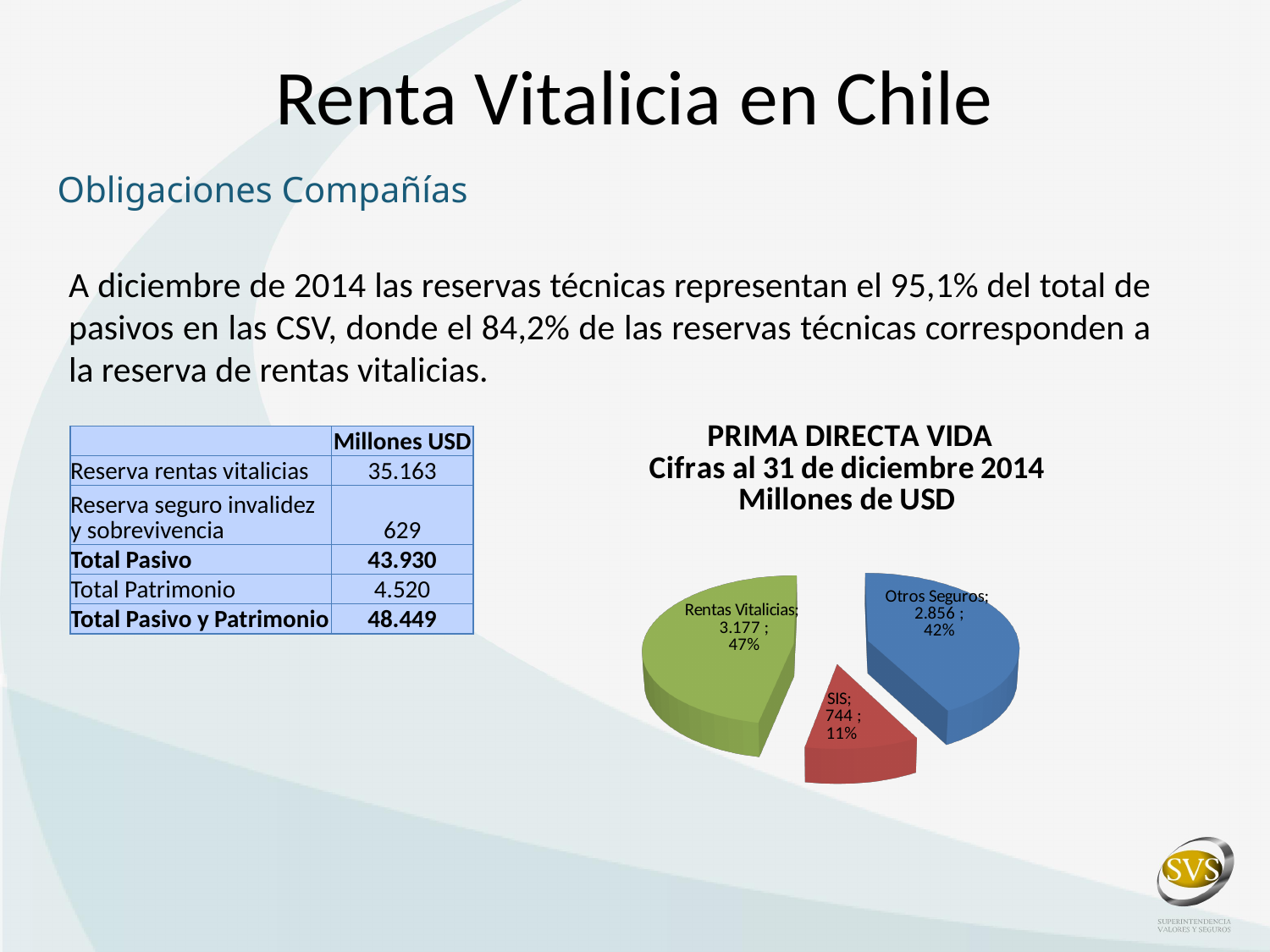
What is the value for SIS in the pie chart? 744 What is the title of the pie chart? PRIMA DIRECTA VIDA Cifras al 31 de diciembre 2014 Millones de USD How many slices does the pie chart have? 3 Which slice of the pie chart is the smallest? SIS What is the value for Rentas Vitalicias in the pie chart? 3.177 What is the value for Otros Seguros in the pie chart? 2.856 What share of the pie does Otros Seguros represent? 42% Which slice of the pie chart is the largest? Rentas Vitalicias What kind of chart is shown on the slide? Pie chart What share of the pie does SIS represent? 11% Which is larger, the value for Otros Seguros or the value for SIS? Otros Seguros What is the difference between the values for Rentas Vitalicias and Otros Seguros? 321